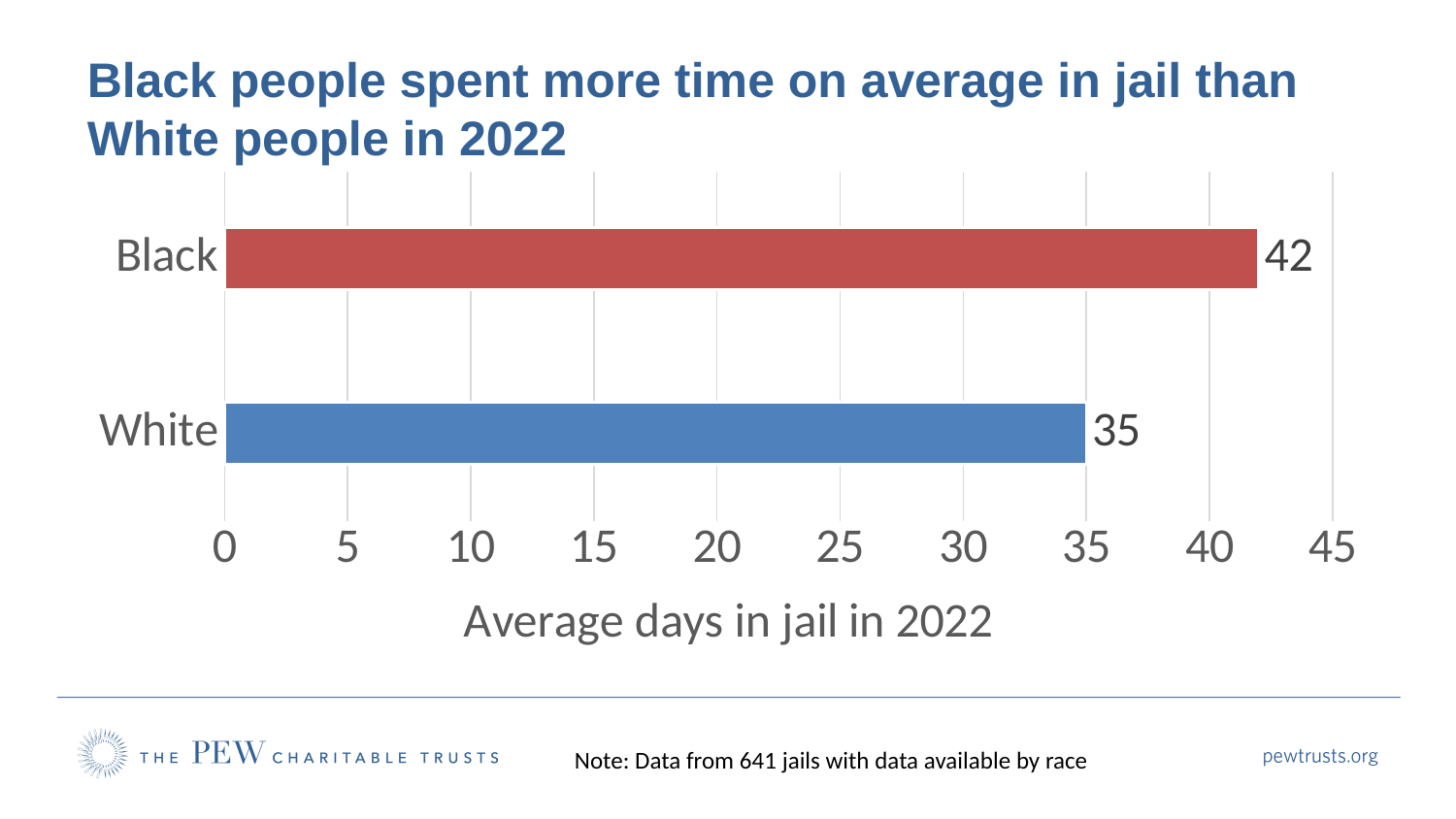
What is the average number of days in jail for Black people? 42 What kind of chart is shown on the slide? bar chart What is the average number of days in jail for White people? 35 Which is larger, the average days in jail for Black people or for White people? Black Is the value for White greater or less than 40? less Is the value for Black greater or less than 40? greater What is the label of the horizontal axis? Average days in jail in 2022 Which group has the highest average days in jail? Black How many categories are shown in the chart? 2 What colour is the bar for Black? red What is the difference in average days in jail between Black and White people? 7 Which group has the lowest average days in jail? White